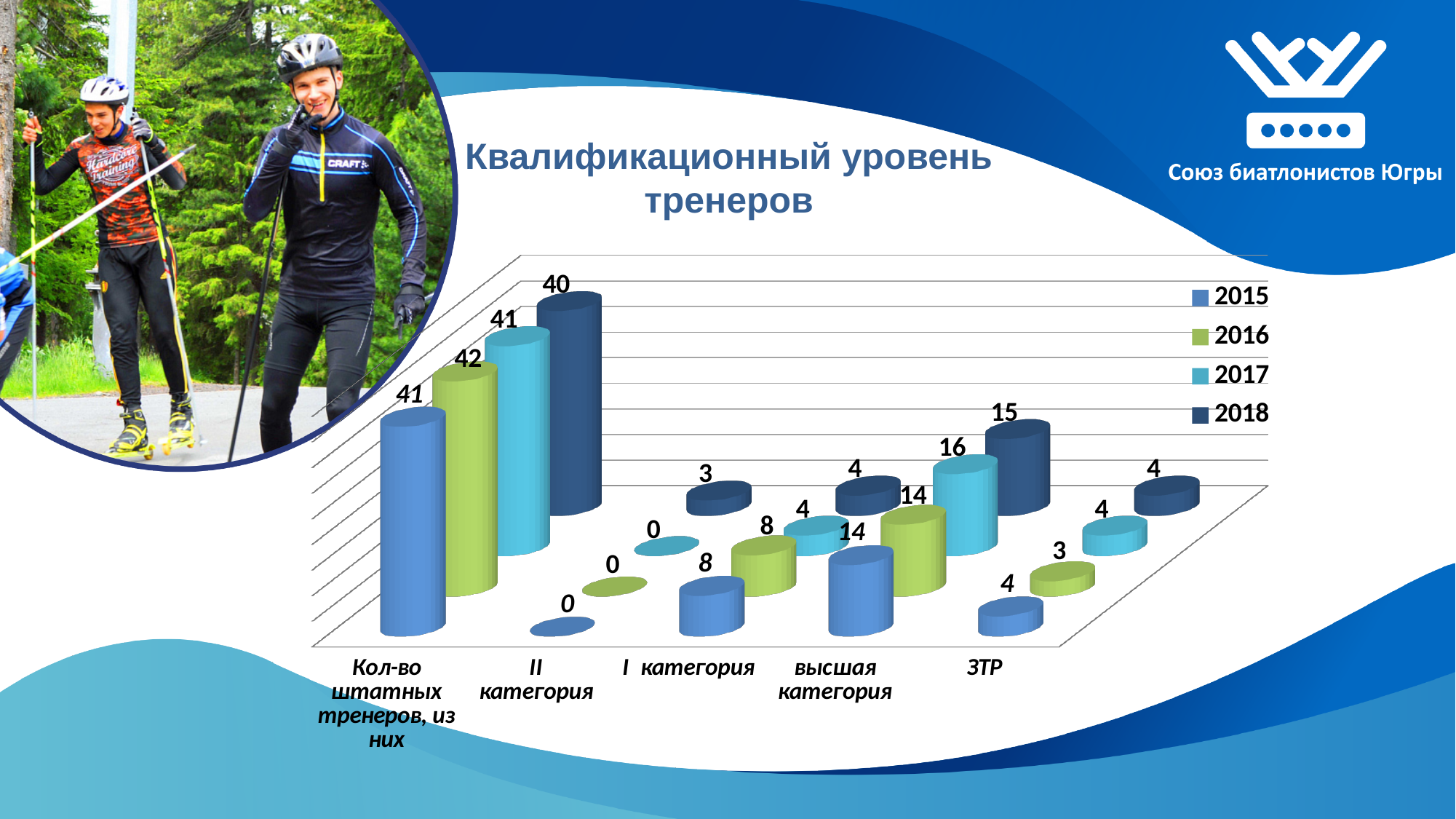
What is the value for 2016 in the category "ЗТР"? 3 How many categories are shown on the x axis of the chart? 5 What is the title of the chart? Квалификационный уровень тренеров What kind of chart is shown on the slide? Bar chart How many series does the legend list? 4 Which is larger in the category "высшая категория": the value for 2017 or the value for 2018? 2017 Which year has the lowest value in the category "высшая категория"? 2015 and 2016 (both 14) What is the value for 2017 in the category "высшая категория"? 16 What is the value for 2016 in the category "Кол-во штатных тренеров, из них"? 42 Which year has the highest value in the category "Кол-во штатных тренеров, из них"? 2016 What is the difference between the 2015 and 2017 values in the category "I категория"? 4 What is the value for 2018 in the category "II категория"? 3